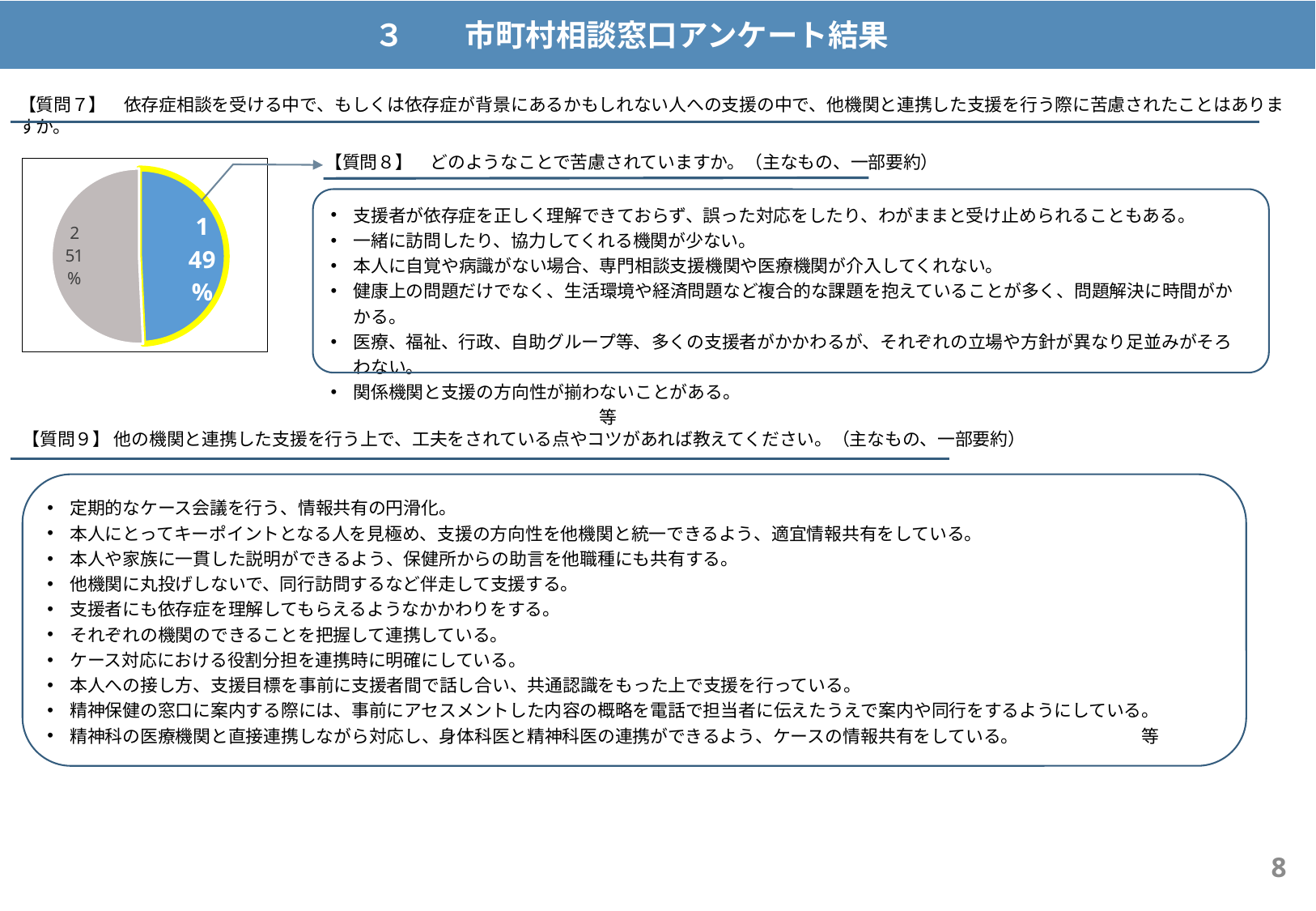
Which slice of the pie chart has the larger share? 2 What is the difference in percentage points between slice 2 and slice 1 in the pie chart? 2 What colour is slice 2 in the pie chart? gray What percentage is shown for slice 1 in the pie chart? 49% Which slice of the pie chart has the smaller share? 1 How many slices does the pie chart have? 2 What kind of chart is shown on the slide? pie chart What colour is slice 1 in the pie chart? blue What percentage is shown for slice 2 in the pie chart? 51% Is the share for slice 1 larger or smaller than the share for slice 2 in the pie chart? smaller What share of the pie does slice 2 represent? 51%